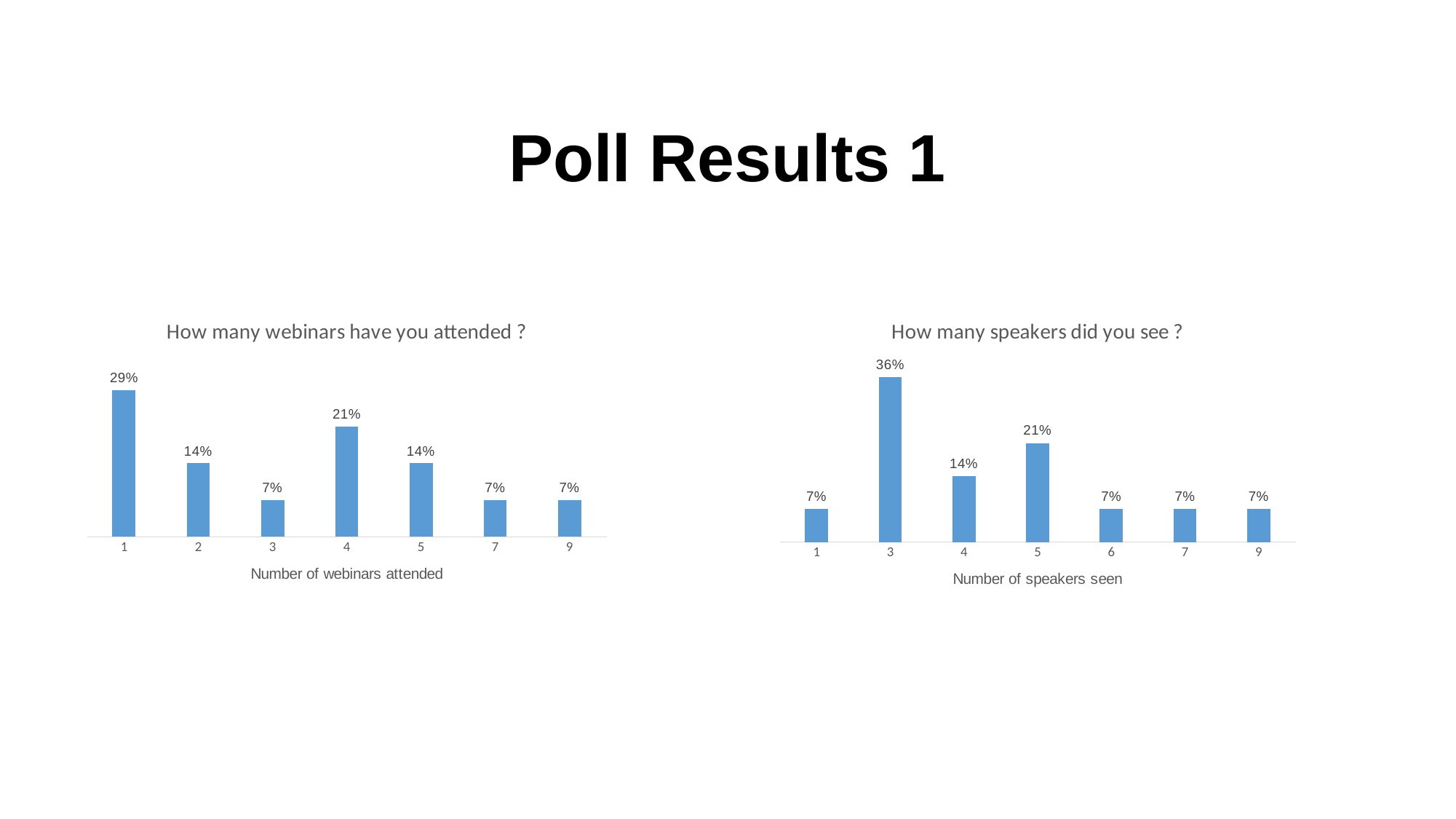
In the chart 'How many webinars have you attended ?', how many categories are shown on the x axis? 7 In the chart 'How many speakers did you see ?', what is the value for category 3? 36% In the chart 'How many speakers did you see ?', what is the difference between the values for category 3 and category 4? 22% What kind of chart is 'How many speakers did you see ?'? Bar chart In the chart 'How many webinars have you attended ?', what is the value for category 1? 29% In the chart 'How many webinars have you attended ?', which category has the highest value? 1 In the chart 'How many speakers did you see ?', which is larger, the value for category 4 or the value for category 5? 5 In the chart 'How many webinars have you attended ?', what is the value for category 4? 21% In the chart 'How many webinars have you attended ?', what is the difference between the values for category 1 and category 2? 15% What is the x-axis title of the chart 'How many webinars have you attended ?'? Number of webinars attended In the chart 'How many speakers did you see ?', what is the value for category 5? 21% In the chart 'How many speakers did you see ?', which category has the highest value? 3